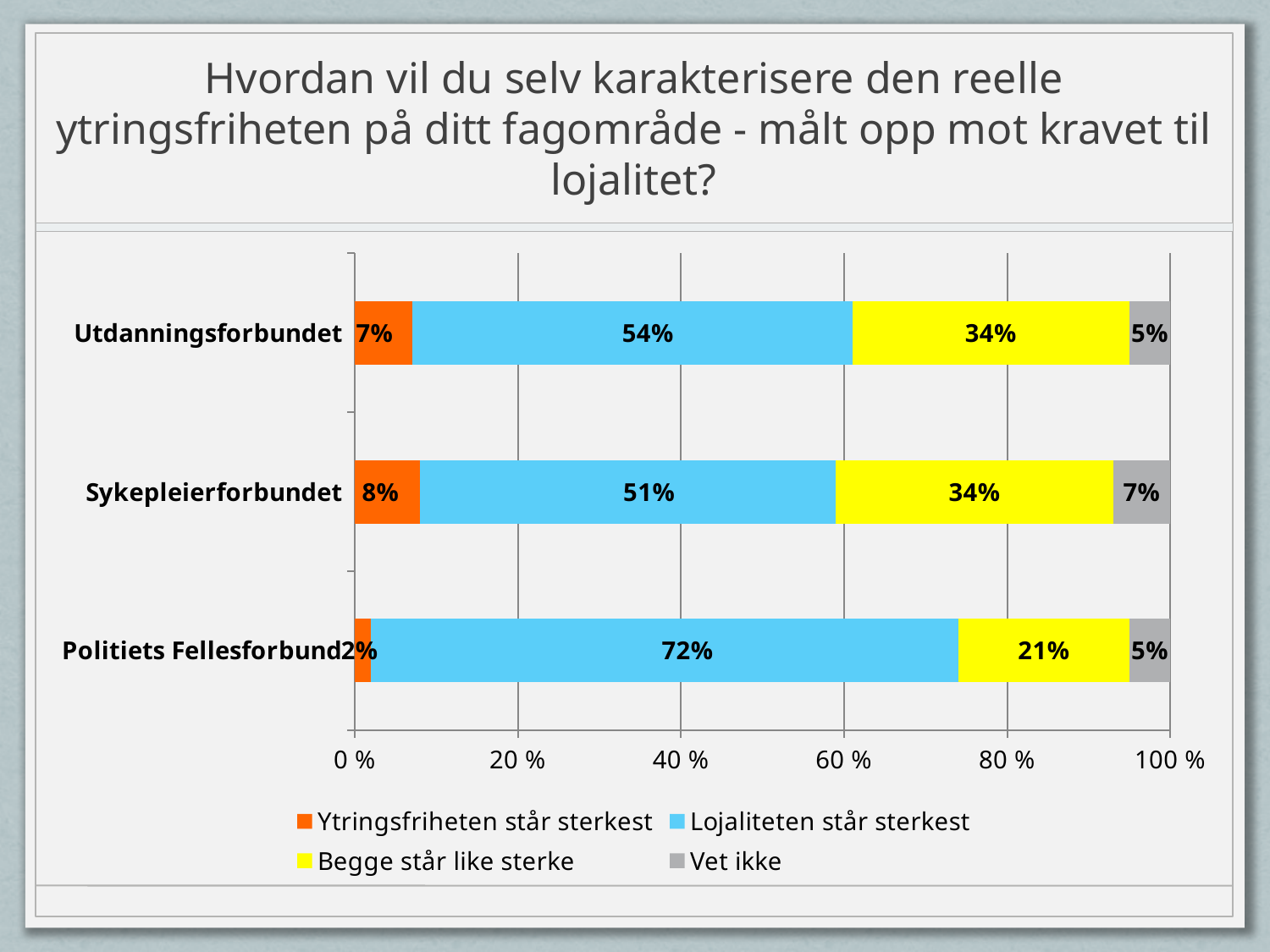
What is the "Vet ikke" value for Sykepleierforbundet? 7% Which category has the lowest value for "Ytringsfriheten står sterkest"? Politiets Fellesforbund Which is larger: the "Begge står like sterke" value for Utdanningsforbundet or for Politiets Fellesforbund? Utdanningsforbundet What is the difference between the "Lojaliteten står sterkest" values for Politiets Fellesforbund and Sykepleierforbundet? 21% Which colour represents "Vet ikke" in the chart? Grey What kind of chart is shown on the slide? Stacked bar chart Which category has the highest value for "Lojaliteten står sterkest"? Politiets Fellesforbund What percentage of Utdanningsforbundet respondents said "Lojaliteten står sterkest"? 54% How many series does the legend list? 4 What is the value for "Begge står like sterke" for Politiets Fellesforbund? 21% What is the "Ytringsfriheten står sterkest" value for Politiets Fellesforbund? 2% How many categories (organisations) are shown on the chart? 3